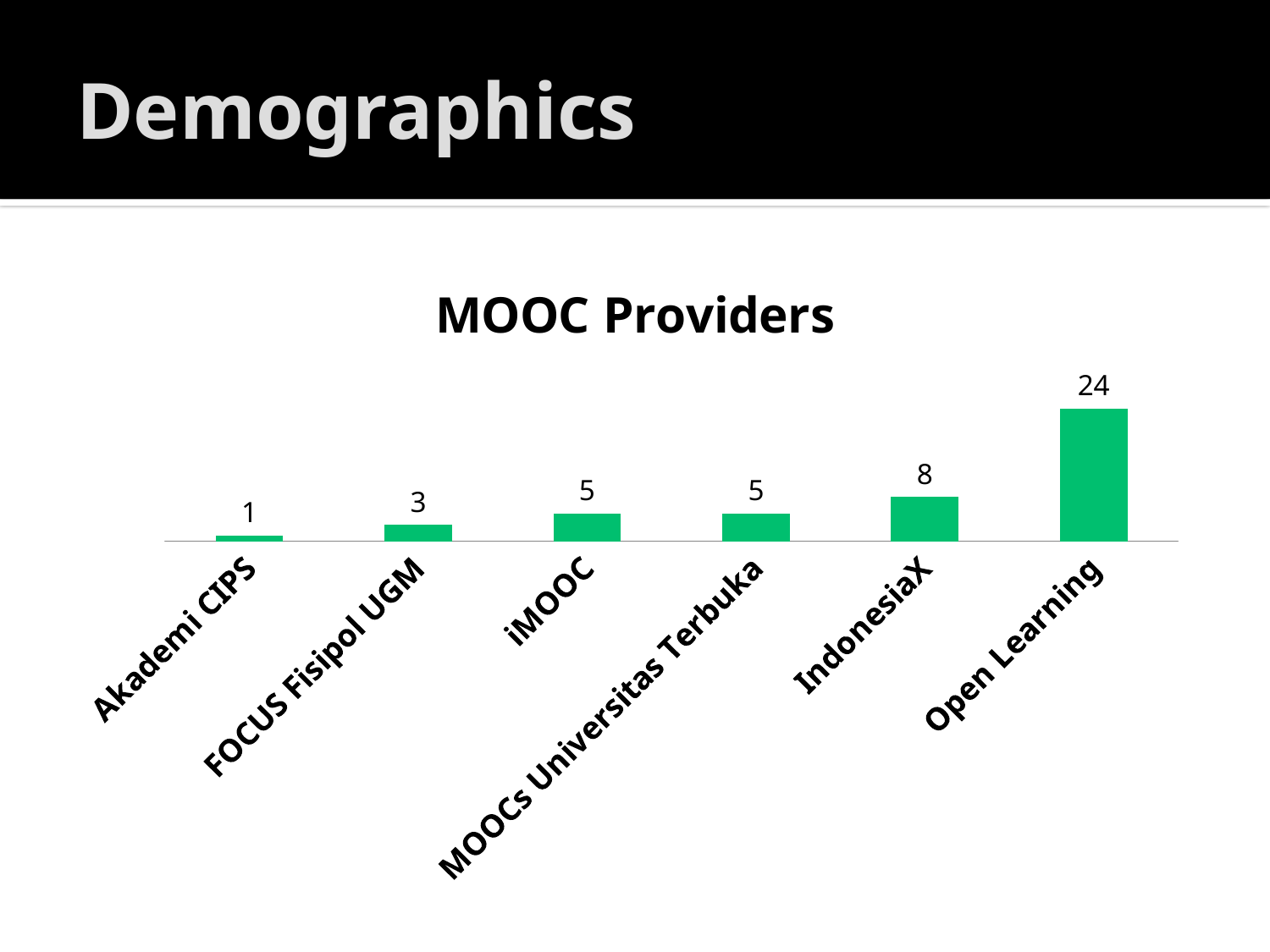
What is the title of the chart? MOOC Providers Which MOOC provider has the lowest value? Akademi CIPS What is the value for Akademi CIPS? 1 How many MOOC providers are shown in the chart? 6 Which is larger, the value for IndonesiaX or the value for MOOCs Universitas Terbuka? IndonesiaX What kind of chart is shown on the slide? Bar chart What is the value for IndonesiaX? 8 Which MOOC provider has the highest value? Open Learning What is the value for FOCUS Fisipol UGM? 3 What is the difference between the values for Open Learning and IndonesiaX? 16 What is the difference between the values for iMOOC and FOCUS Fisipol UGM? 2 What is the value for Open Learning? 24